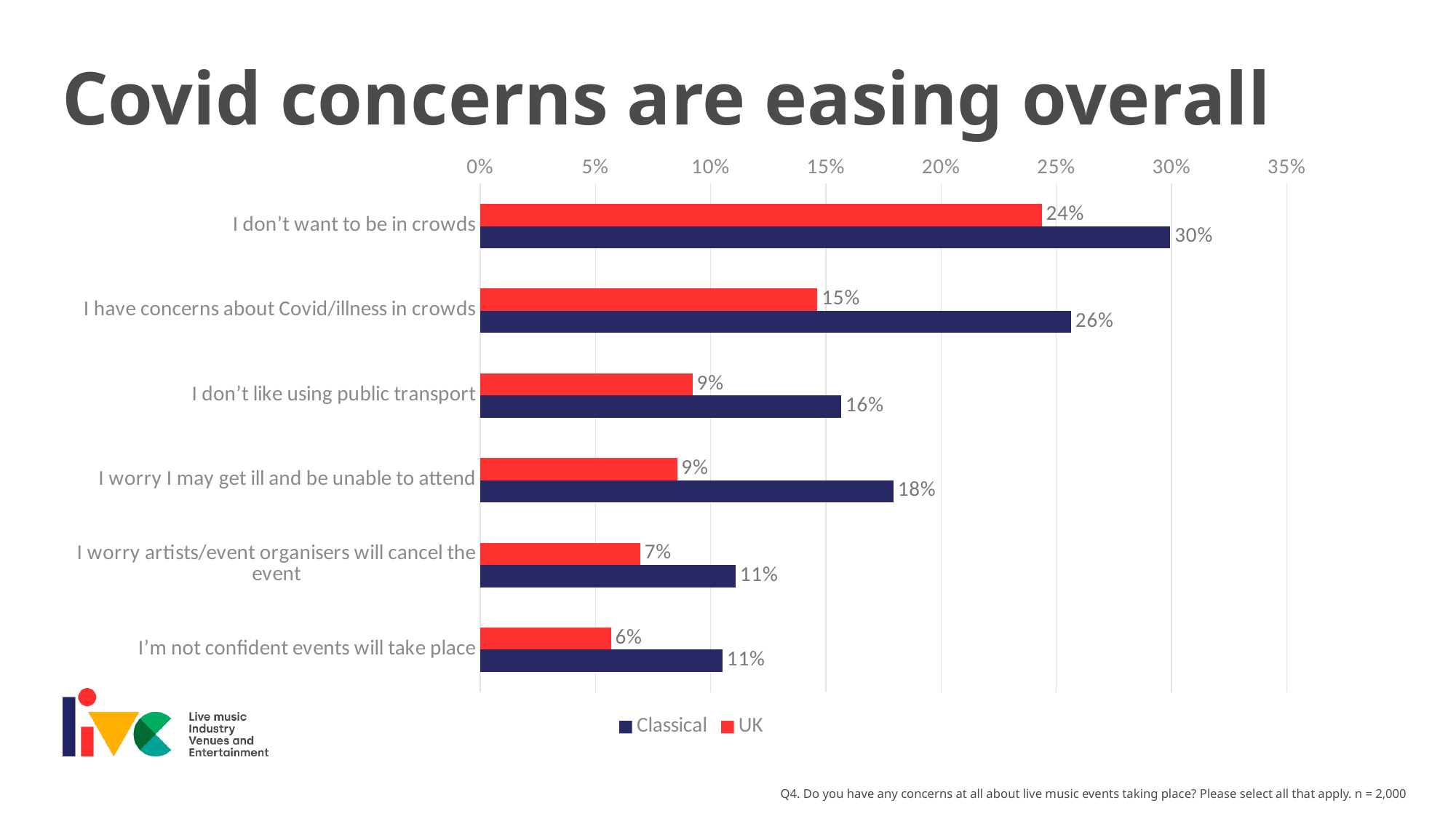
What is the Classical value for "I don't want to be in crowds"? 30% Which is larger for "I worry I may get ill and be unable to attend": the Classical value or the UK value? Classical How many series does the legend list? 2 How many categories are shown on the chart? 6 What kind of chart is shown on the slide? bar chart Which category has the lowest UK value? I'm not confident events will take place Which category has the highest Classical value? I don't want to be in crowds What is the UK value for "I have concerns about Covid/illness in crowds"? 15% What is the difference between the Classical and UK values for "I don't like using public transport"? 7% What is the UK value for "I'm not confident events will take place"? 6% Is the Classical value for "I worry artists/event organisers will cancel the event" greater or less than 10%? greater What is the difference between the Classical and UK values for "I have concerns about Covid/illness in crowds"? 11%